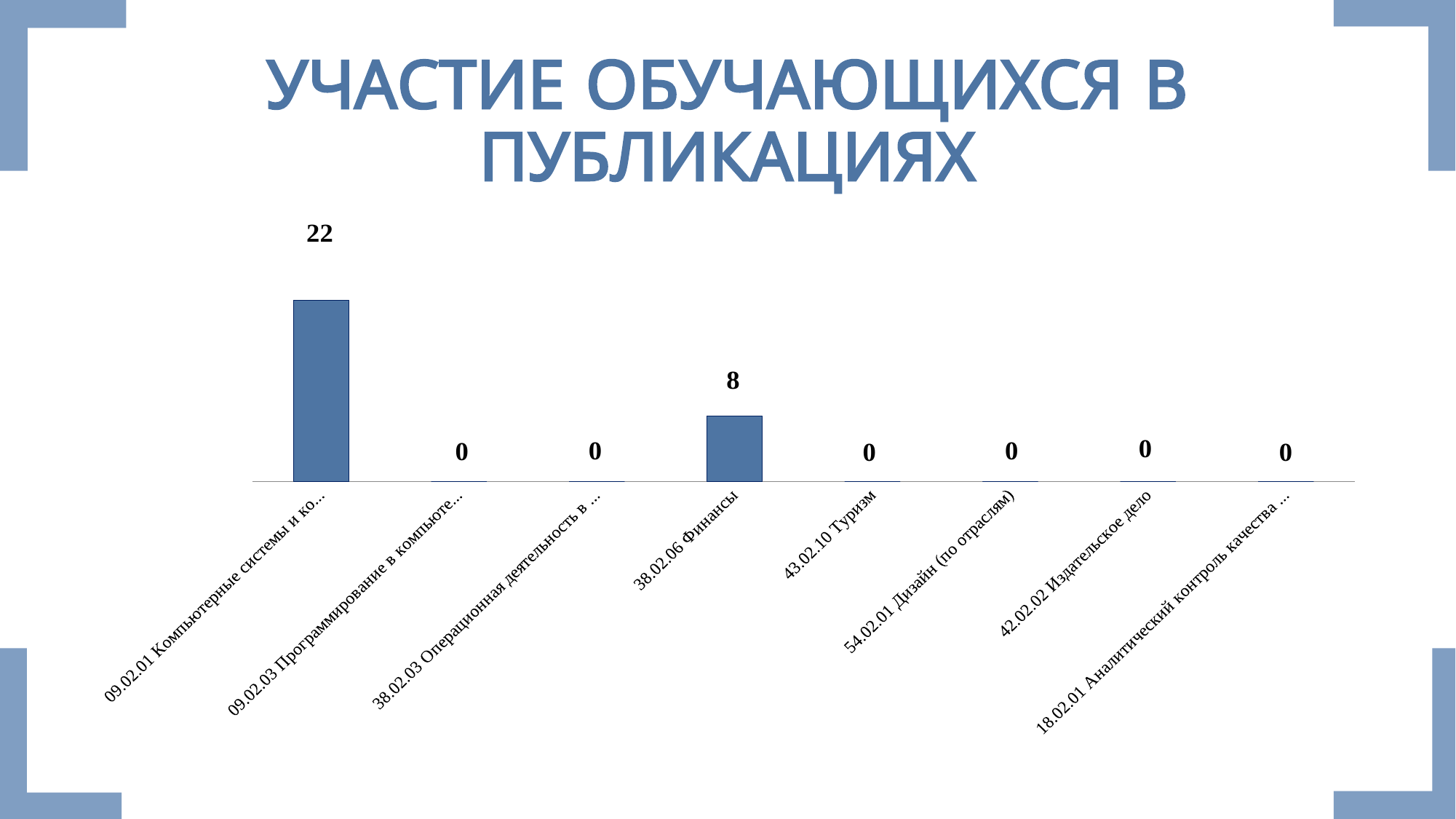
What is the value for 43.02.10 Туризм? 0 Which is larger, the value for 38.02.06 Финансы or the value for 54.02.01 Дизайн (по отраслям)? 38.02.06 Финансы What kind of chart is shown on the slide? bar chart What colour are the bars in the chart? blue What is the value for 38.02.06 Финансы? 8 What is the value for the category labelled 09.02.01 (Компьютерные системы и ко...)? 22 What is the value for 42.02.02 Издательское дело? 0 What is the title of the slide containing the chart? УЧАСТИЕ ОБУЧАЮЩИХСЯ В ПУБЛИКАЦИЯХ How many categories are shown on the x axis? 8 Which category has the highest value? 09.02.01 Компьютерные системы и ко... How many categories have a value of 0? 6 What is the difference between the values for 09.02.01 and 38.02.06 Финансы? 14